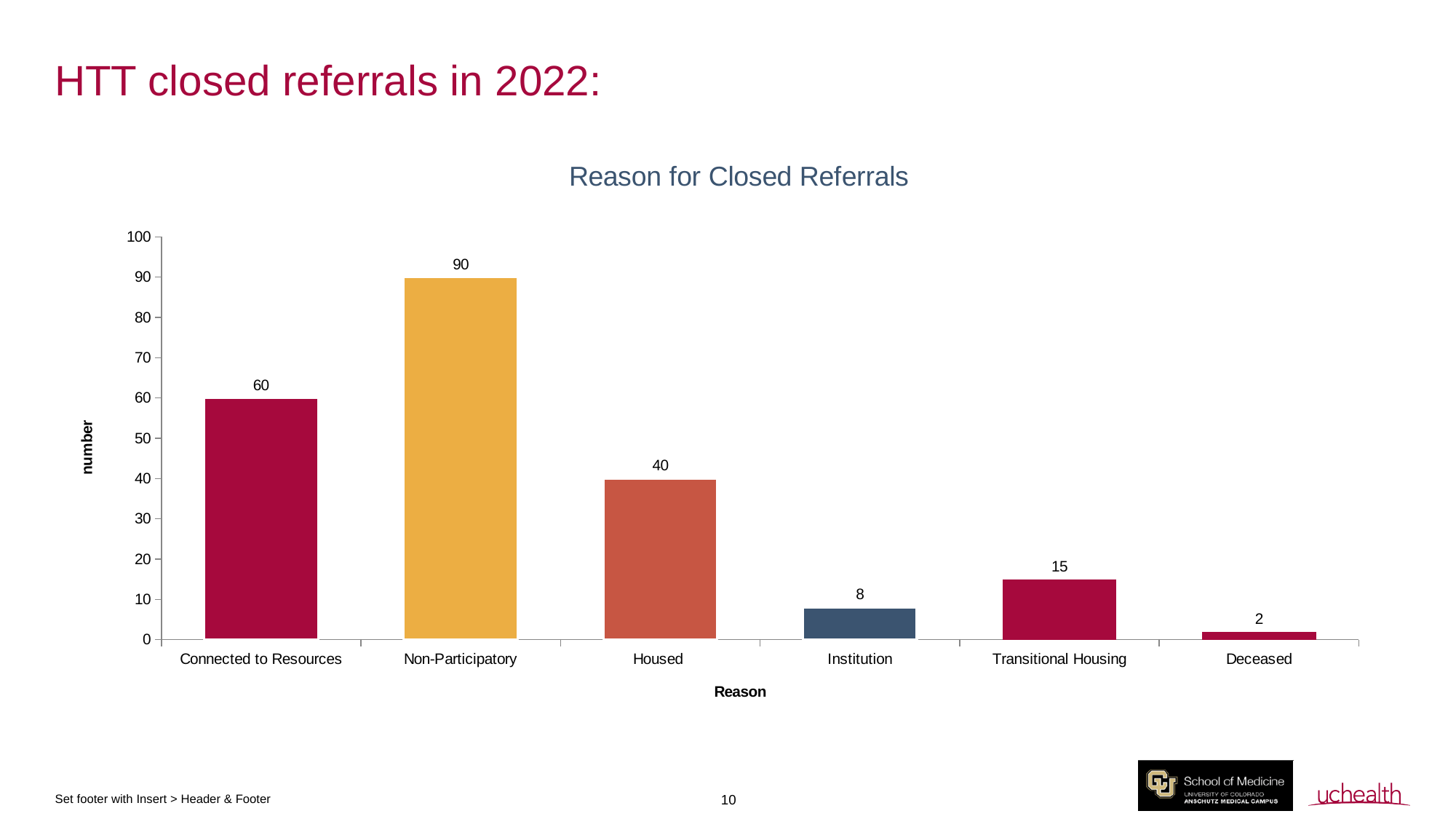
Which reason has the highest number of closed referrals? Non-Participatory What is the value for Non-Participatory? 90 What kind of chart is shown on the slide? Bar chart What is the value for Institution? 8 Which reason has the lowest number of closed referrals? Deceased What is the difference between the values for Non-Participatory and Connected to Resources? 30 What is the value for Transitional Housing? 15 What is the title of the chart? Reason for Closed Referrals How many reason categories are shown on the chart? 6 Which is larger, the value for Housed or the value for Institution? Housed Is the value for Connected to Resources greater or less than 50? greater What is the difference between the values for Housed and Transitional Housing? 25